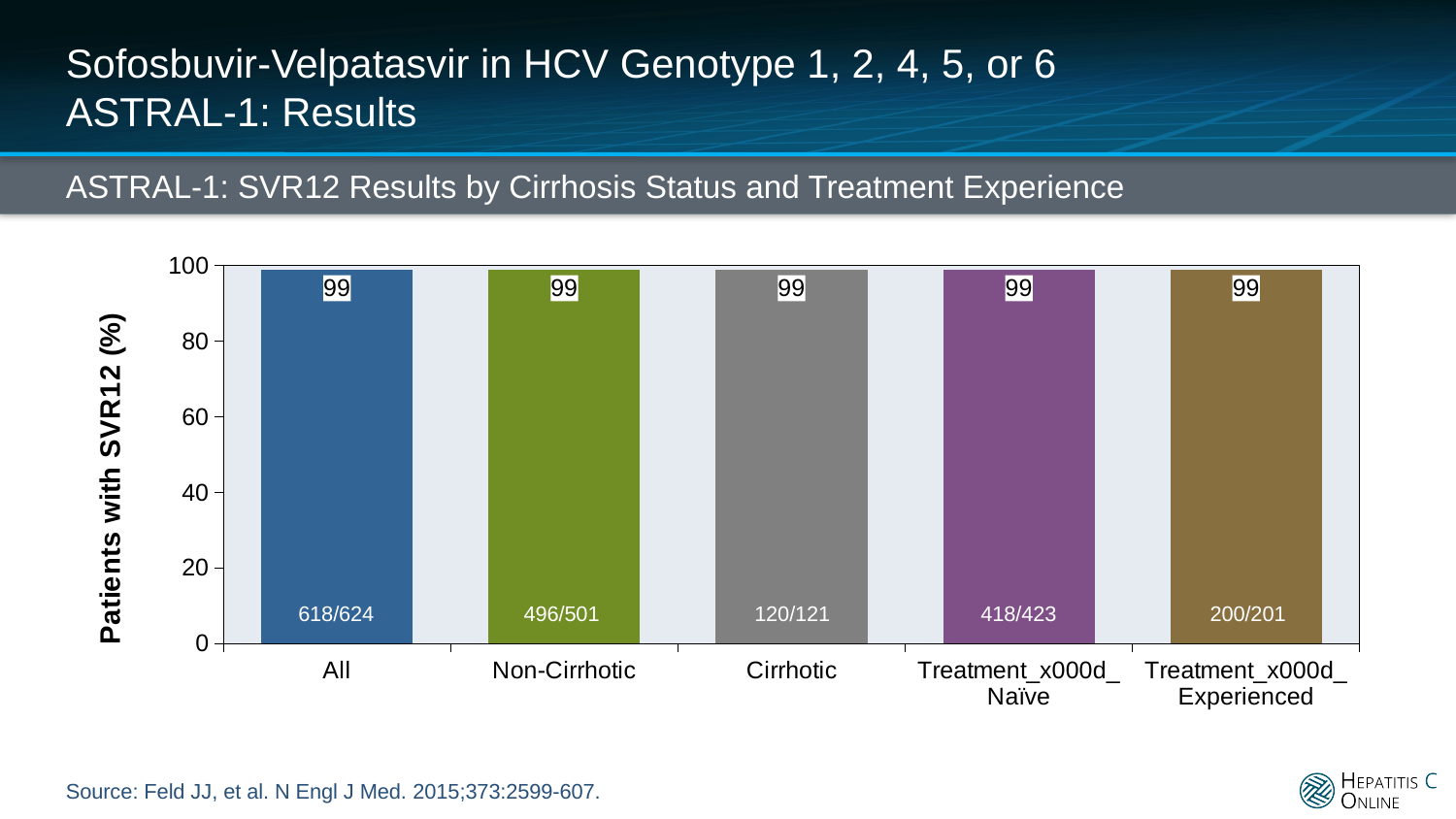
What fraction of patients is printed on the Cirrhotic bar? 120/121 What fraction of patients is printed on the Non-Cirrhotic bar? 496/501 What fraction of patients is printed on the Treatment Naïve bar? 418/423 What fraction of patients is printed on the Treatment Experienced bar? 200/201 What is the difference between the SVR12 percentage for Non-Cirrhotic and Cirrhotic patients? 0 What is the SVR12 percentage for the All group? 99 What is the label on the y axis of the chart? Patients with SVR12 (%) Do the values rise, fall, or stay the same across the categories from left to right? stay the same How many categories are shown on the x axis of the chart? 5 What kind of chart is shown on the slide? bar chart What is the SVR12 percentage for the Cirrhotic group? 99 Is the value for the Cirrhotic group greater or less than 80? greater